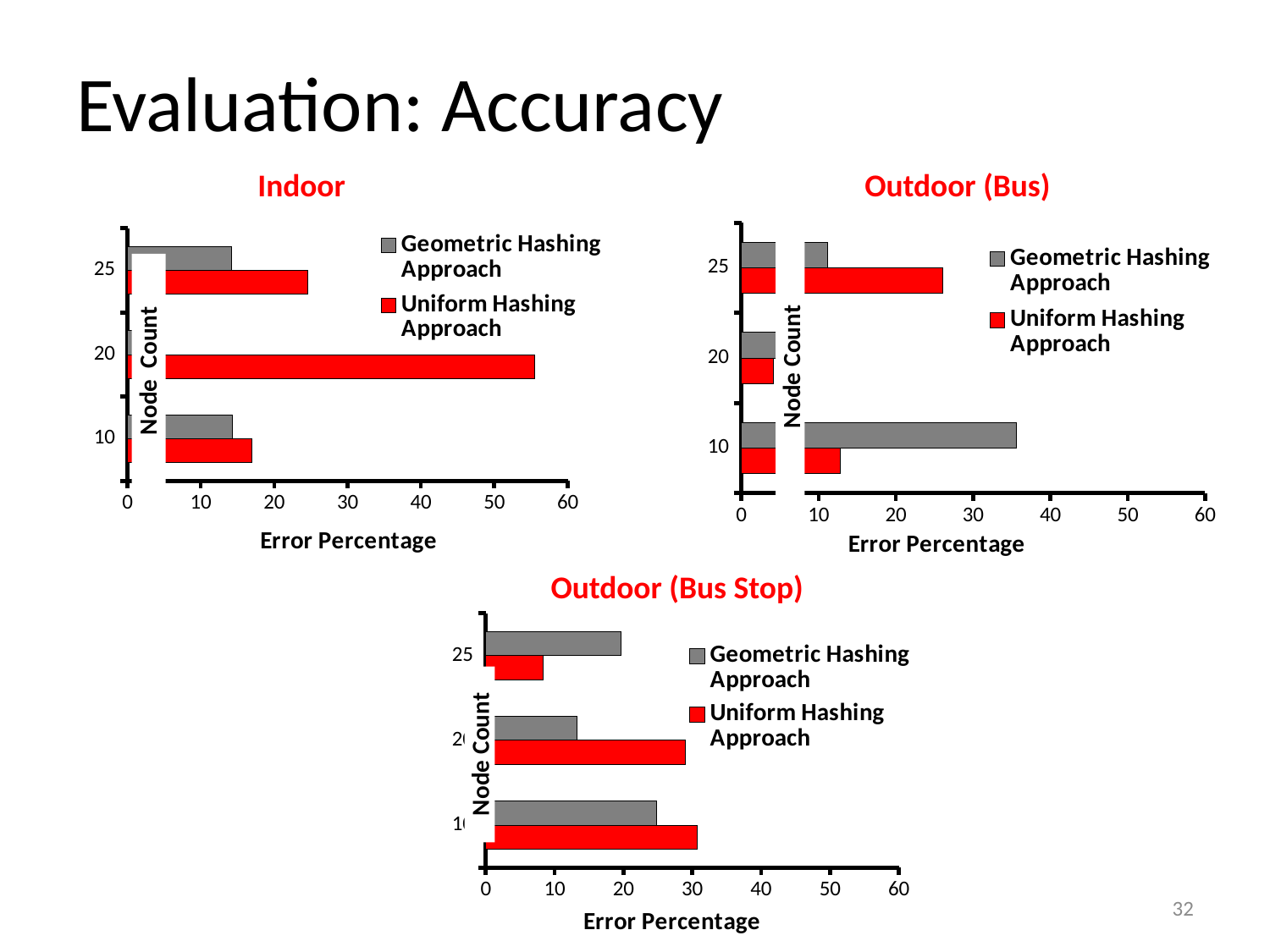
On the Outdoor (Bus) chart, which node count has the highest error percentage for the Geometric Hashing Approach? 10 On the Indoor chart, what kind of chart is shown? bar chart On the Outdoor (Bus) chart, is the Geometric Hashing Approach error percentage for node count 10 greater or less than 30? greater On the Outdoor (Bus Stop) chart, how many node count categories are plotted? 3 On the Indoor chart, is the Uniform Hashing Approach error percentage for node count 20 greater or less than 50? greater On the Outdoor (Bus) chart, which approach has the larger error percentage for node count 25, Geometric Hashing or Uniform Hashing? Uniform Hashing Approach On the Outdoor (Bus Stop) chart, what is the label of the horizontal axis? Error Percentage On the Outdoor (Bus Stop) chart, is the Uniform Hashing Approach error percentage for node count 20 greater or less than 20? greater On the Outdoor (Bus Stop) chart, which approach has the larger error percentage for node count 25, Geometric Hashing or Uniform Hashing? Geometric Hashing Approach On the Indoor chart, how many series does the legend list? 2 On the Indoor chart, what colour represents the Uniform Hashing Approach? red On the Indoor chart, which node count has the highest error percentage for the Uniform Hashing Approach? 20